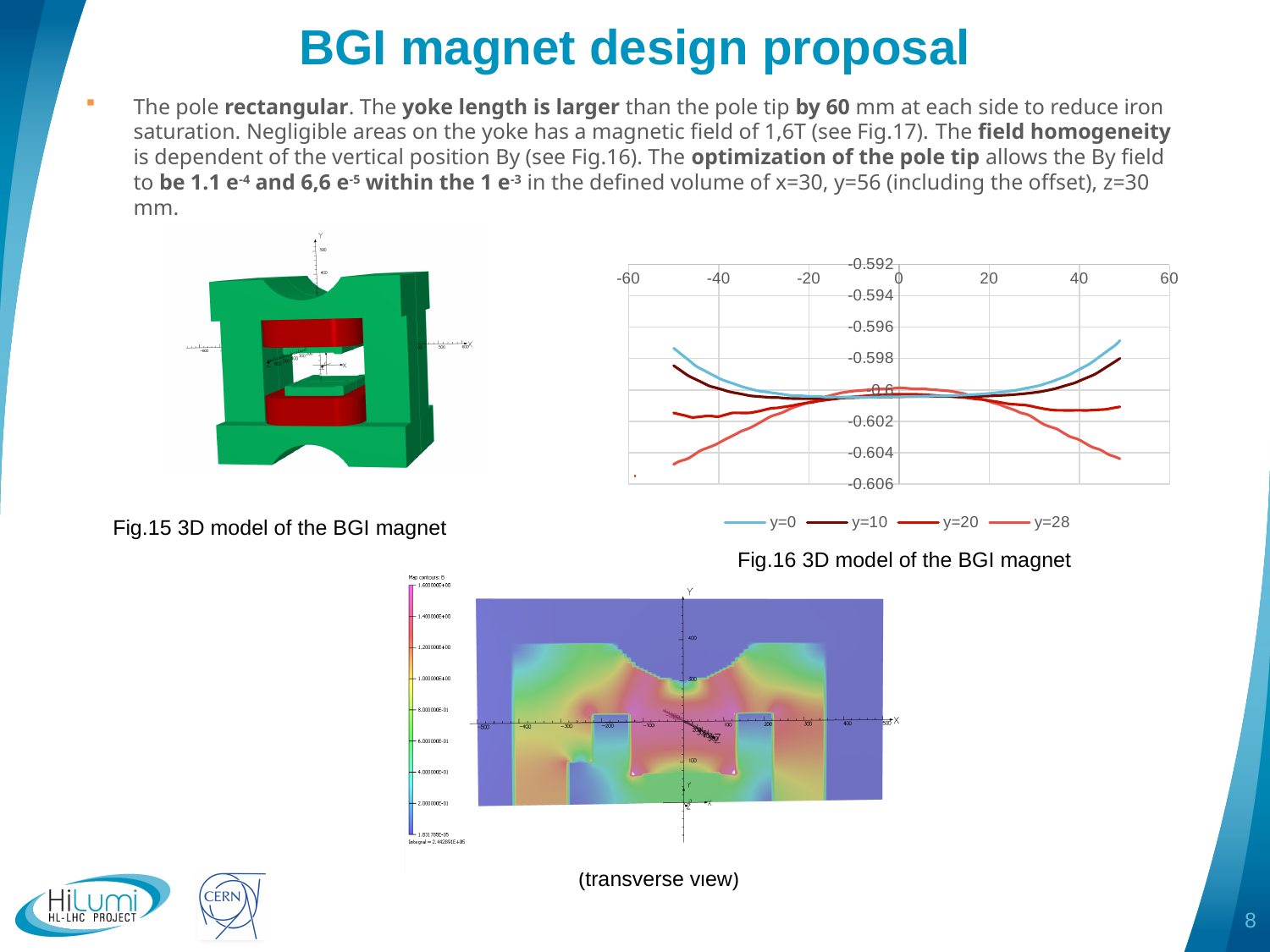
In the Fig.16 line chart, at x=50 which series has the larger value, y=0 or y=28? y=0 How many series does the legend of the Fig.16 line chart list? 4 In the Fig.16 line chart, what is the range of the x axis? -60 to 60 In the Fig.16 line chart, which series reaches the highest value at the right end of the plotted range (around x=50)? y=0 In the Fig.16 line chart, at x=50 is the value of the y=0 series greater or less than -0.598? greater What are the series names in the legend of the Fig.16 line chart? y=0, y=10, y=20, y=28 In the Fig.16 line chart, does the y=0 series rise or fall as x goes from 0 to 50? rise In the Fig.16 line chart, which series has the lowest value at the right end of the plotted range (around x=50)? y=28 In the Fig.16 line chart, at x=50 is the value of the y=28 series greater or less than -0.602? less In the Fig.16 line chart, at x=-50 is the value of the y=20 series greater or less than -0.6? less In the Fig.16 line chart, does the y=28 series rise or fall as x goes from 0 to 50? fall What kind of chart is Fig.16 on the right of the slide? line chart